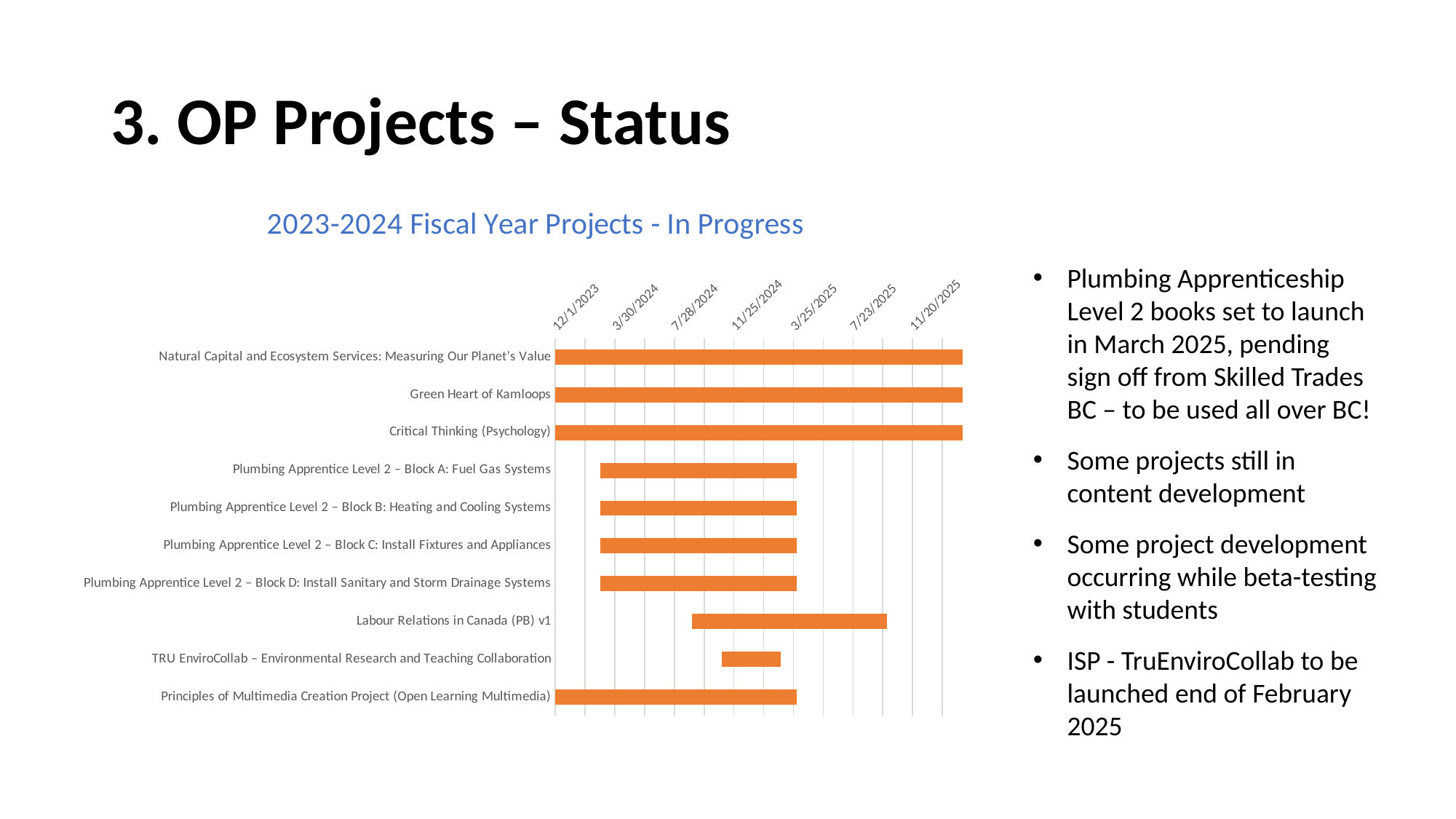
Does the bar for Critical Thinking (Psychology) end before or after 11/20/2025? after Which bar is longer: Labour Relations in Canada (PB) v1 or TRU EnviroCollab – Environmental Research and Teaching Collaboration? Labour Relations in Canada (PB) v1 Which bar is longer: Green Heart of Kamloops or Plumbing Apprentice Level 2 – Block A: Fuel Gas Systems? Green Heart of Kamloops Does the bar for Labour Relations in Canada (PB) v1 start before or after 7/28/2024? after What colour are the bars on the chart? Orange Does the bar for Plumbing Apprentice Level 2 – Block A: Fuel Gas Systems start before or after 12/1/2023? after Which project has the shortest bar on the chart? TRU EnviroCollab – Environmental Research and Teaching Collaboration What kind of chart is shown on the slide? Bar chart What is the title of the chart? 2023-2024 Fiscal Year Projects - In Progress How many date labels are shown along the chart's date axis? 7 How many projects are listed on the chart? 10